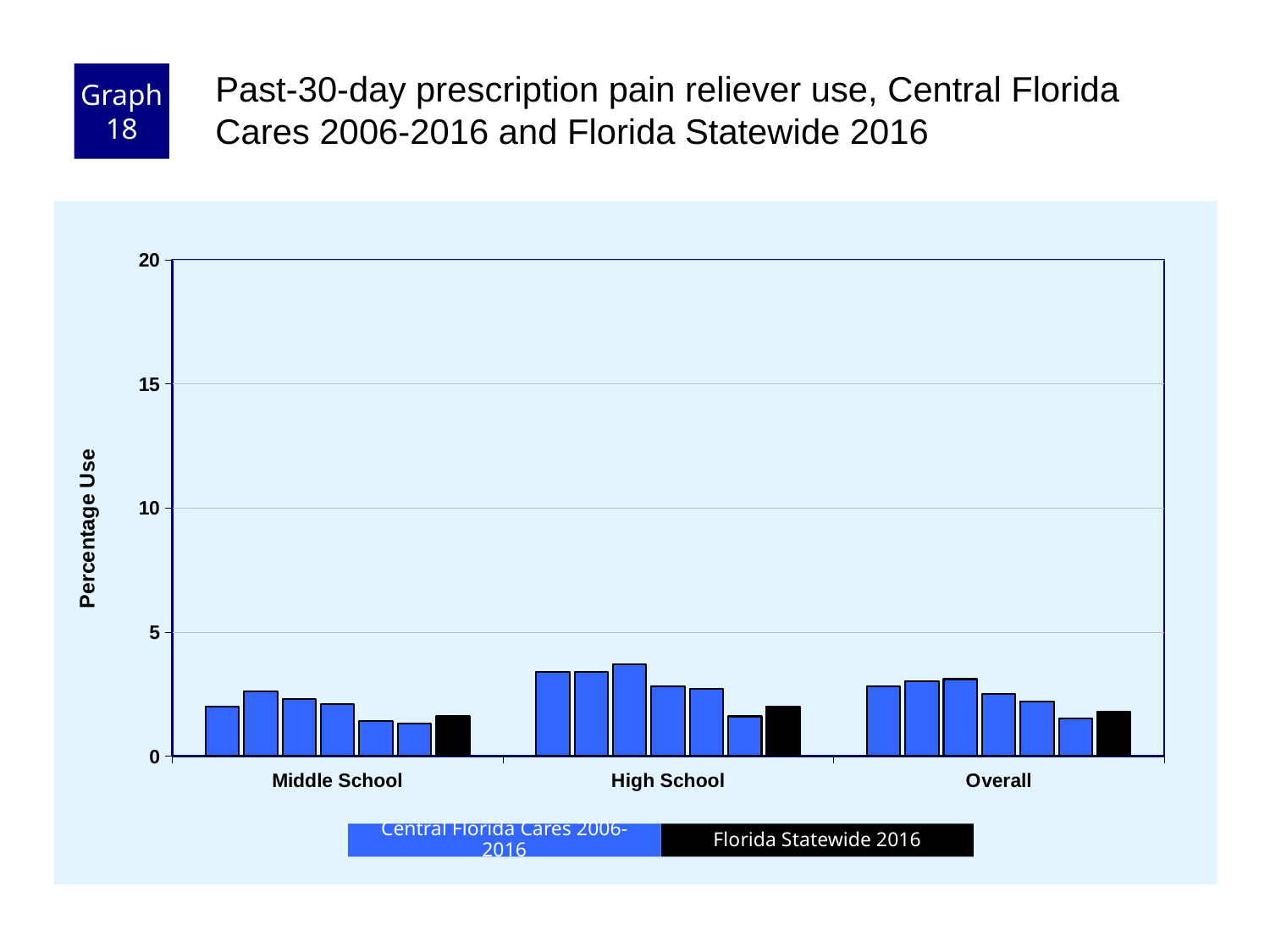
What kind of chart is shown on the slide? bar chart How many categories are shown along the x axis? 3 Are all the bars in the Overall group greater or less than 10? less Which is larger: the tallest Central Florida Cares bar for High School or the tallest Central Florida Cares bar for Middle School? High School Is the tallest bar in the High School group greater or less than 5? less Do the Central Florida Cares 2006-2016 bars in the High School group generally rise or fall from left to right? fall What is the title of the y axis? Percentage Use How many bars are plotted in each category group? 7 What colour are the Florida Statewide 2016 bars? black How many series does the legend list? 2 Is the Florida Statewide 2016 value for Middle School greater or less than 5? less Which category contains the tallest bar on the chart? High School